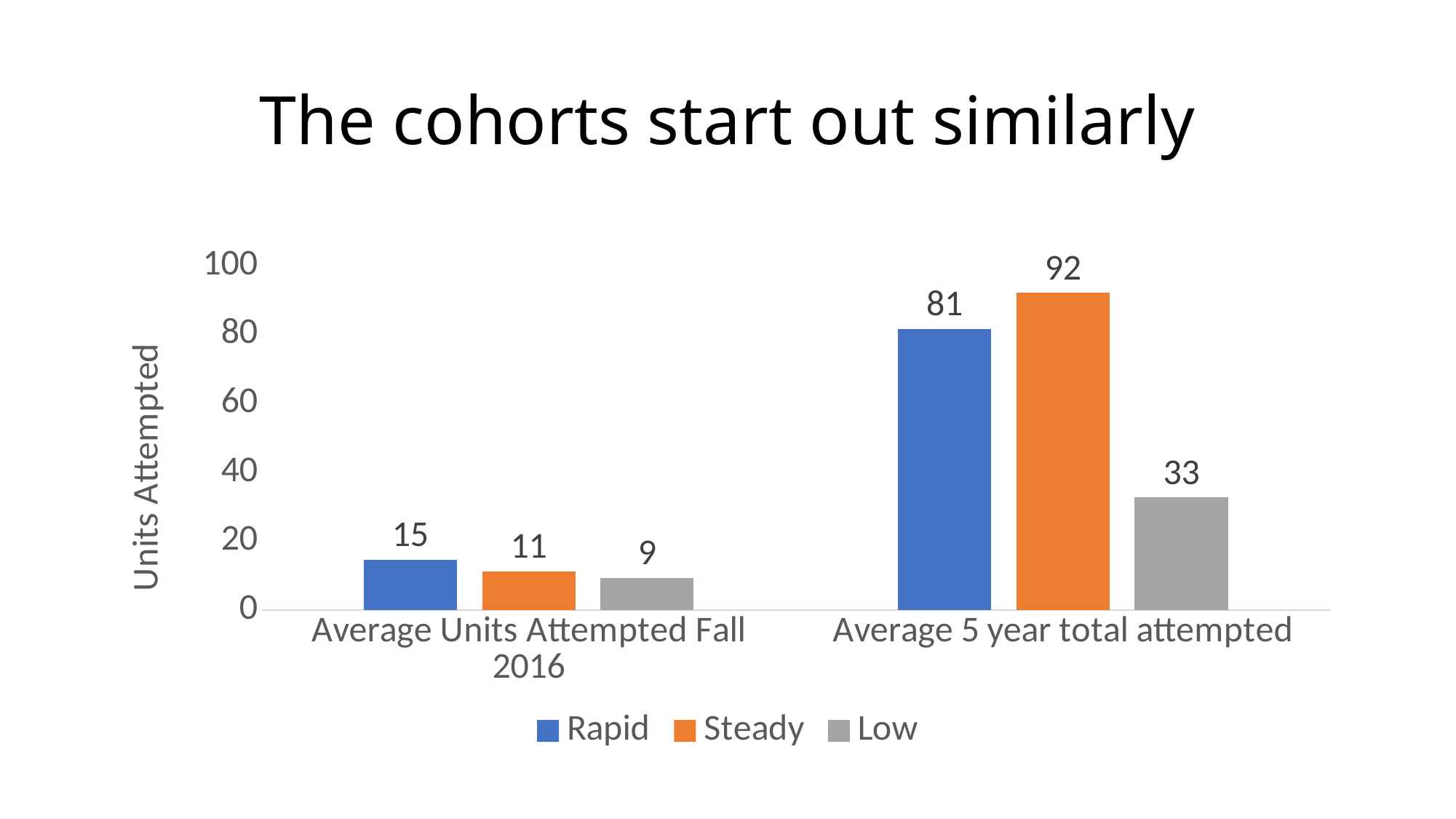
What is the value for Rapid in the Average Units Attempted Fall 2016 category? 15 Which series has the highest value in the Average 5 year total attempted category? Steady Which series has the lowest value in the Average Units Attempted Fall 2016 category? Low Is the value for Rapid in the Average 5 year total attempted category greater or less than 60? greater Which is larger: the Rapid value or the Steady value in the Average Units Attempted Fall 2016 category? Rapid How many series does the legend list? 3 What is the value for Steady in the Average 5 year total attempted category? 92 What is the difference between the Steady and Rapid values in the Average 5 year total attempted category? 11 What is the difference between the Rapid and Low values in the Average Units Attempted Fall 2016 category? 6 What kind of chart is shown on the slide? bar chart How many categories are shown on the x axis? 2 What is the value for Low in the Average 5 year total attempted category? 33